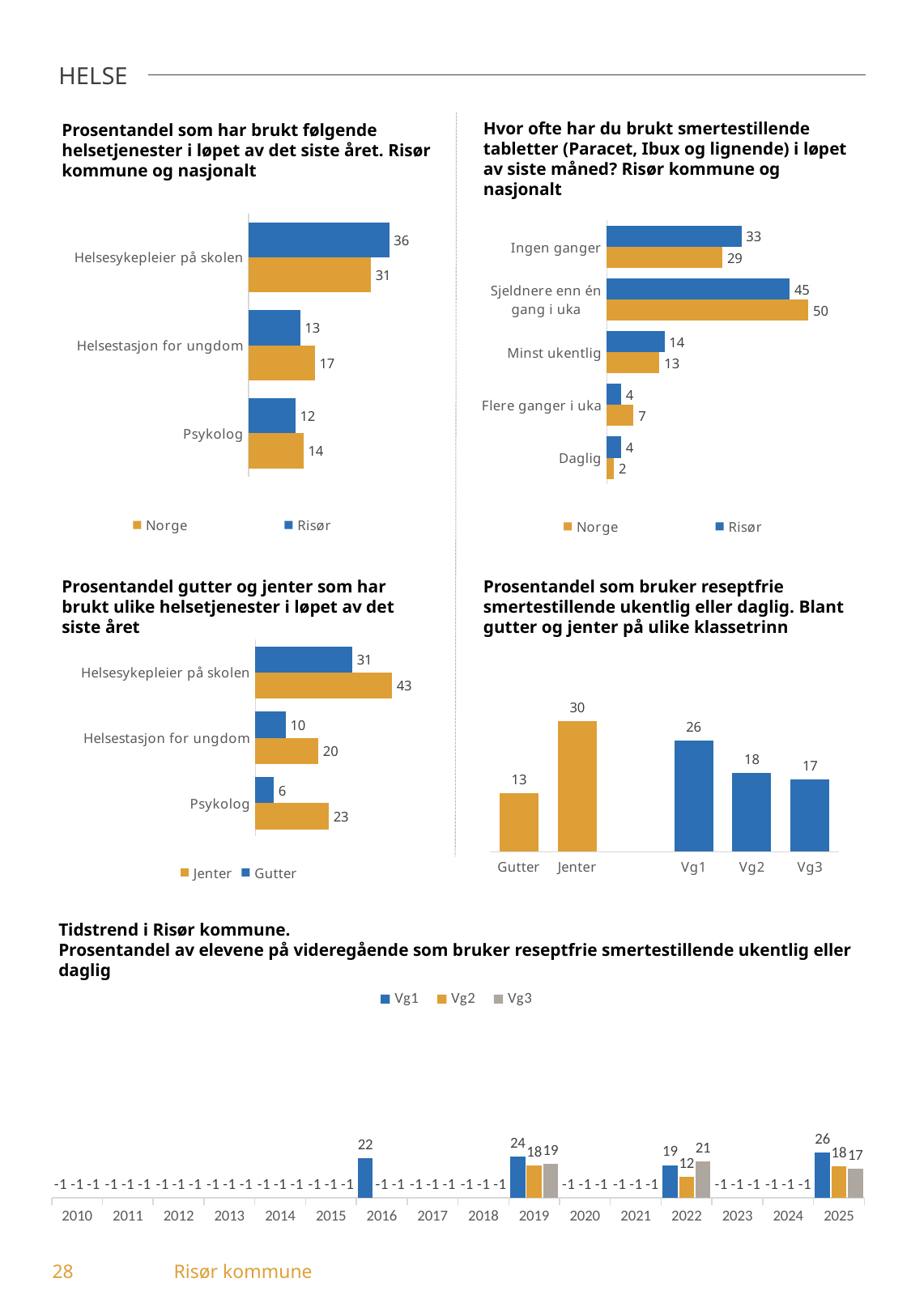
In the chart 'Tidstrend i Risør kommune', what is the Vg3 value for 2022? 21 In the chart 'Prosentandel som har brukt følgende helsetjenester i løpet av det siste året. Risør kommune og nasjonalt', what is the difference between the Norge and Risør values for Helsestasjon for ungdom? 4 In the chart 'Prosentandel som har brukt følgende helsetjenester i løpet av det siste året. Risør kommune og nasjonalt', what is the Risør value for Helsesykepleier på skolen? 36 In the chart 'Hvor ofte har du brukt smertestillende tabletter (Paracet, Ibux og lignende) i løpet av siste måned? Risør kommune og nasjonalt', which category has the lowest Norge value? Daglig What kind of chart is 'Prosentandel som bruker reseptfrie smertestillende ukentlig eller daglig. Blant gutter og jenter på ulike klassetrinn'? Bar chart In the chart 'Prosentandel som bruker reseptfrie smertestillende ukentlig eller daglig. Blant gutter og jenter på ulike klassetrinn', what is the value for Vg2? 18 In the chart 'Tidstrend i Risør kommune', how many series does the legend list? 3 In the chart 'Hvor ofte har du brukt smertestillende tabletter (Paracet, Ibux og lignende) i løpet av siste måned? Risør kommune og nasjonalt', how many categories are shown? 5 In the chart 'Prosentandel som bruker reseptfrie smertestillende ukentlig eller daglig. Blant gutter og jenter på ulike klassetrinn', which category has the highest value? Jenter In the chart 'Prosentandel gutter og jenter som har brukt ulike helsetjenester i løpet av det siste året', which is larger for Helsesykepleier på skolen, Gutter or Jenter? Jenter In the chart 'Hvor ofte har du brukt smertestillende tabletter (Paracet, Ibux og lignende) i løpet av siste måned? Risør kommune og nasjonalt', what is the Norge value for Sjeldnere enn én gang i uka? 50 In the chart 'Prosentandel gutter og jenter som har brukt ulike helsetjenester i løpet av det siste året', what is the Jenter value for Psykolog? 23